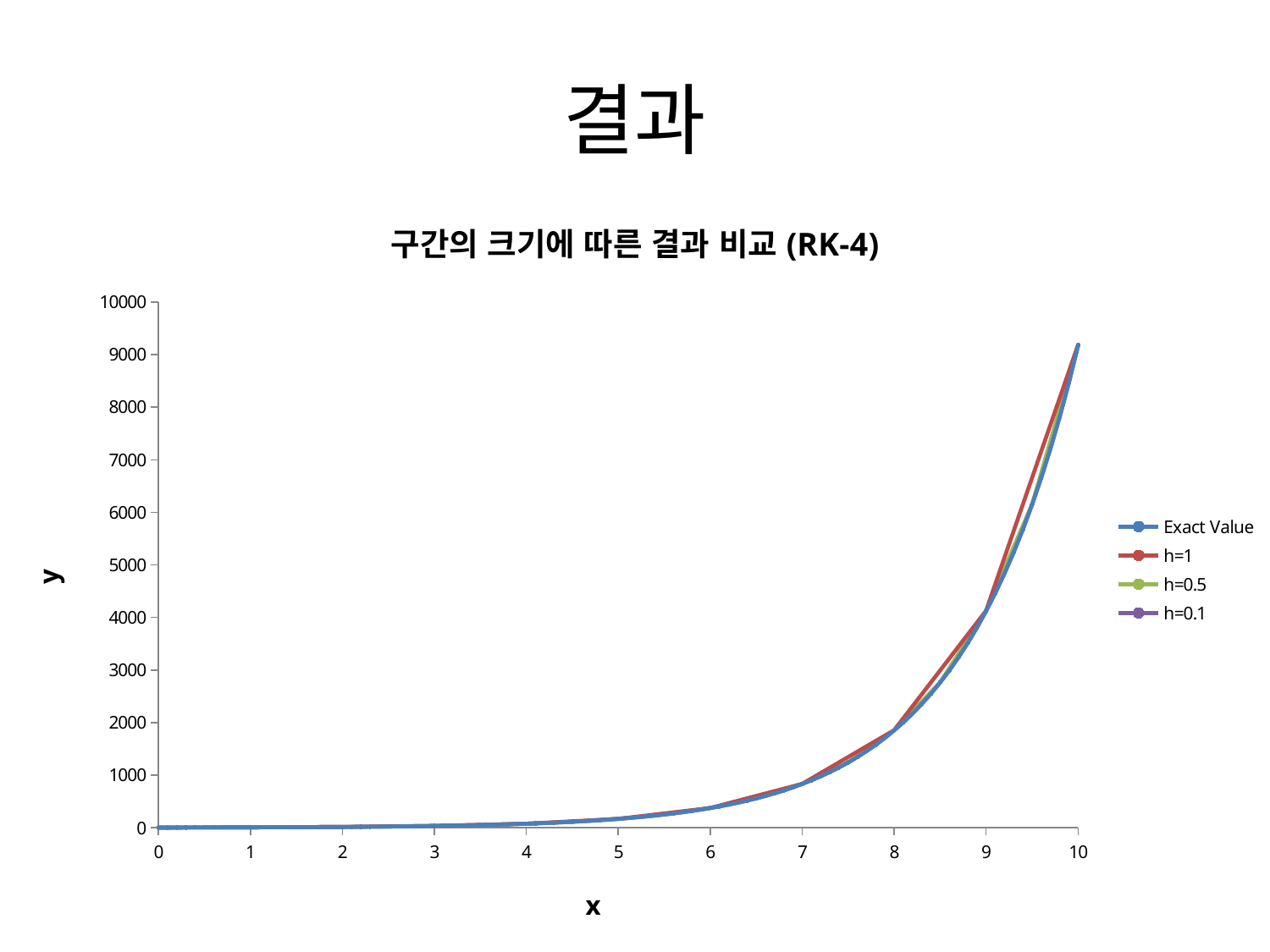
Is the value of the Exact Value series at x=7 greater or less than 1000? less Is the value of the h=1 series at x=5 greater or less than 1000? less What kind of chart is shown on the slide? line chart Which series are listed in the legend? Exact Value, h=1, h=0.5, h=0.1 What is the title of the chart? 구간의 크기에 따른 결과 비교 (RK-4) Is the value of the h=1 series at x=9 greater or less than 3000? greater Do the plotted values rise or fall as x increases from 0 to 10? rise How many series does the legend list? 4 Which is larger for the Exact Value series: the value at x=10 or the value at x=9? the value at x=10 What is the highest value shown on the y axis? 10000